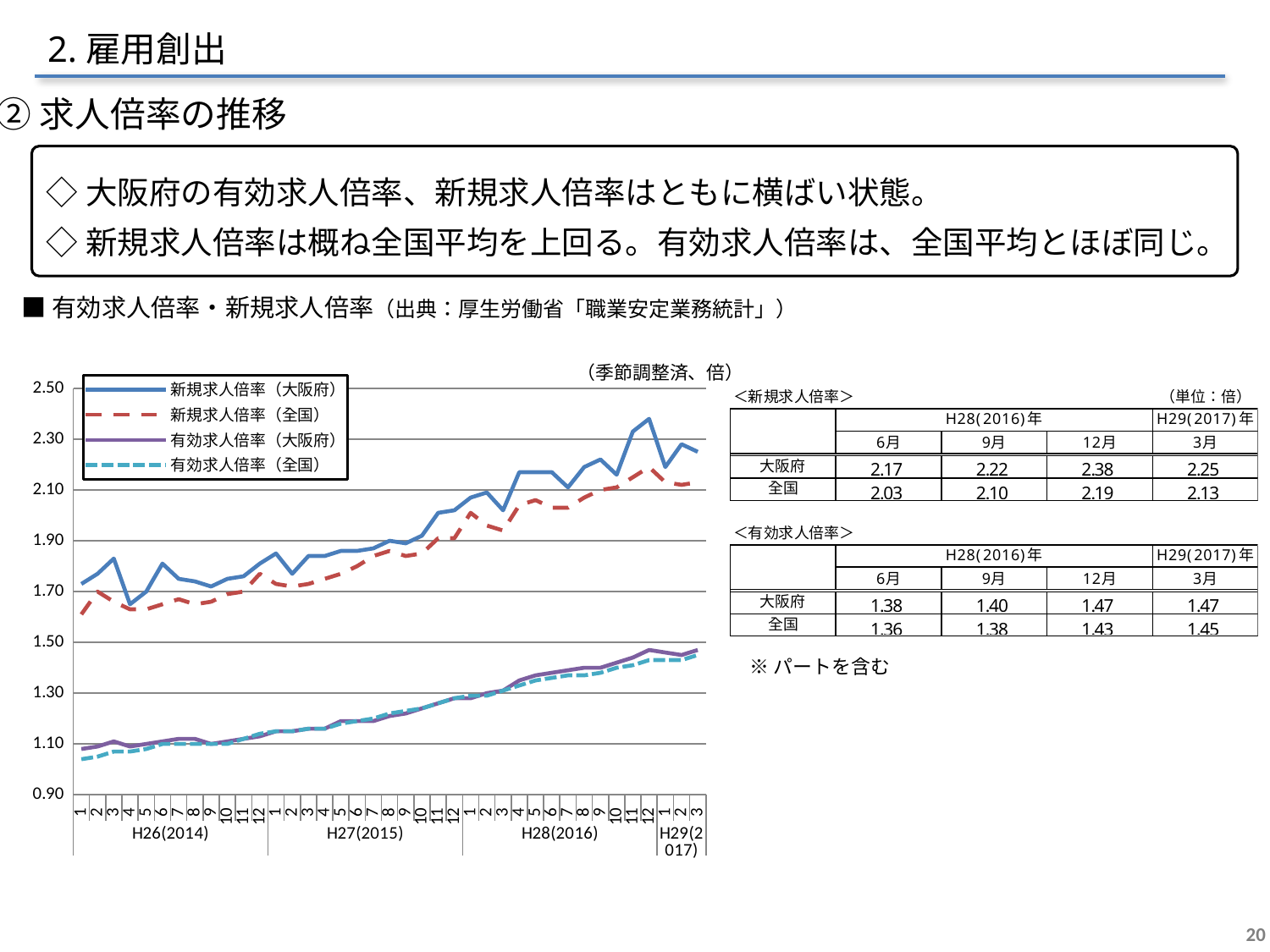
According to the 有効求人倍率 table, what is the value for 全国 in 3月 of H29(2017)? 1.45 Is the value of 有効求人倍率（全国） at month 1 of H26(2014) greater or less than 1.10? less In 12月 of H28(2016), which is larger for 新規求人倍率: 大阪府 or 全国? 大阪府 What kind of chart is shown on the slide? line chart Which series is drawn as a solid blue line in the chart? 新規求人倍率（大阪府） Is the value of 新規求人倍率（大阪府） at month 12 of H28(2016) greater or less than 2.30? greater According to the 新規求人倍率 table, what is the value for 大阪府 in 12月 of H28(2016)? 2.38 Does the 有効求人倍率（大阪府） line rise or fall from H26(2014) to H29(2017)? rise How many series does the chart legend list? 4 In the 新規求人倍率 table, what is the difference between 大阪府 and 全国 in 9月 of H28(2016)? 0.12 In the 新規求人倍率 table, which month has the highest value for 大阪府? 12月 of H28(2016) Is the value of 新規求人倍率（全国） at month 1 of H26(2014) greater or less than 1.70? less